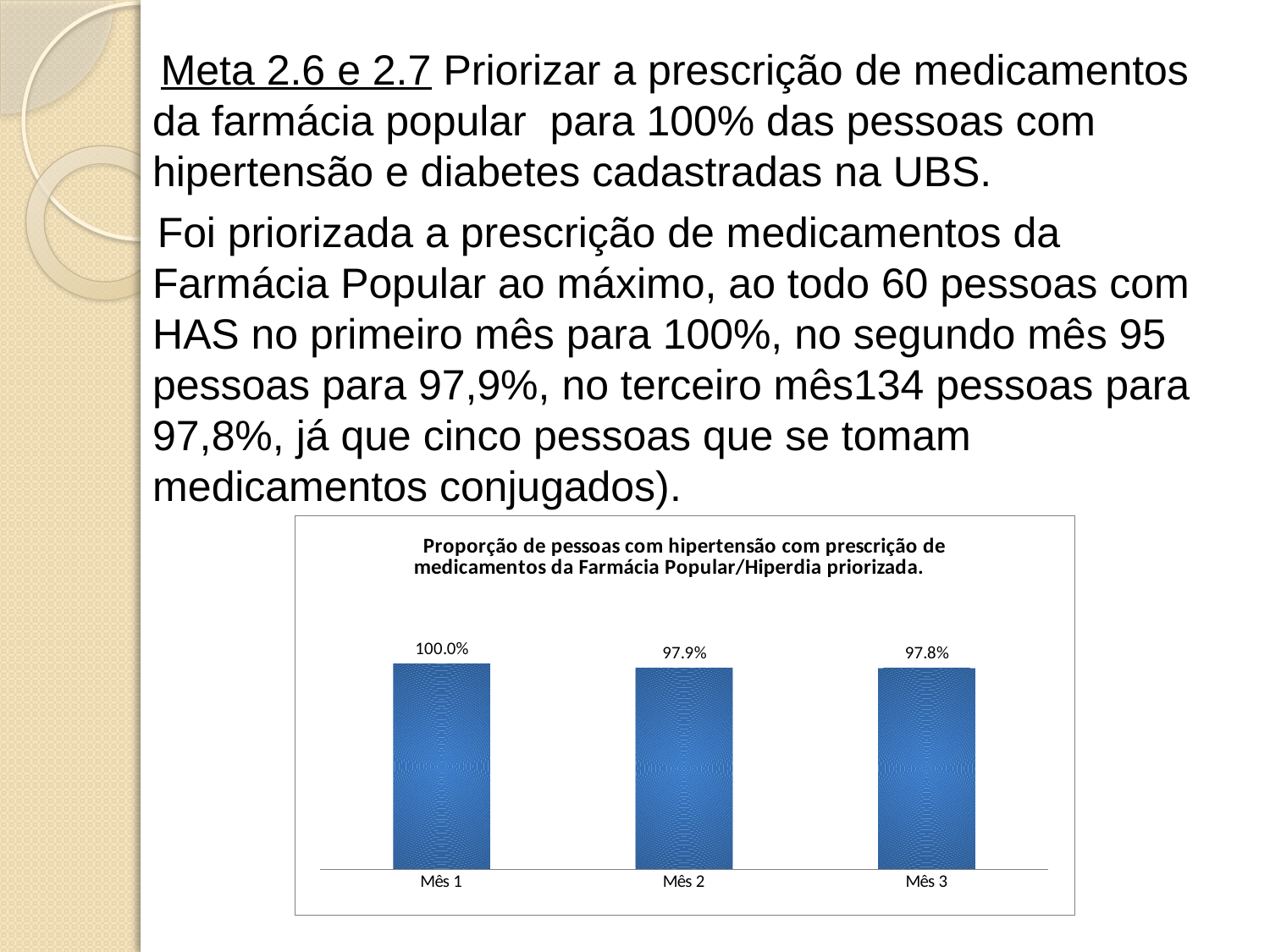
What is the difference between the values for Mês 1 and Mês 3? 2.2% What colour are the bars in the chart? Blue What kind of chart is shown on the slide? Bar chart What is the value for Mês 1? 100.0% How many months are shown on the chart? 3 Do the values rise or fall from Mês 1 to Mês 3? Fall What is the title of the chart? Proporção de pessoas com hipertensão com prescrição de medicamentos da Farmácia Popular/Hiperdia priorizada. Which month has the highest value? Mês 1 What is the value for Mês 2? 97.9% What is the value for Mês 3? 97.8% Which is larger, the value for Mês 1 or the value for Mês 2? Mês 1 What is the difference between the values for Mês 1 and Mês 2? 2.1%